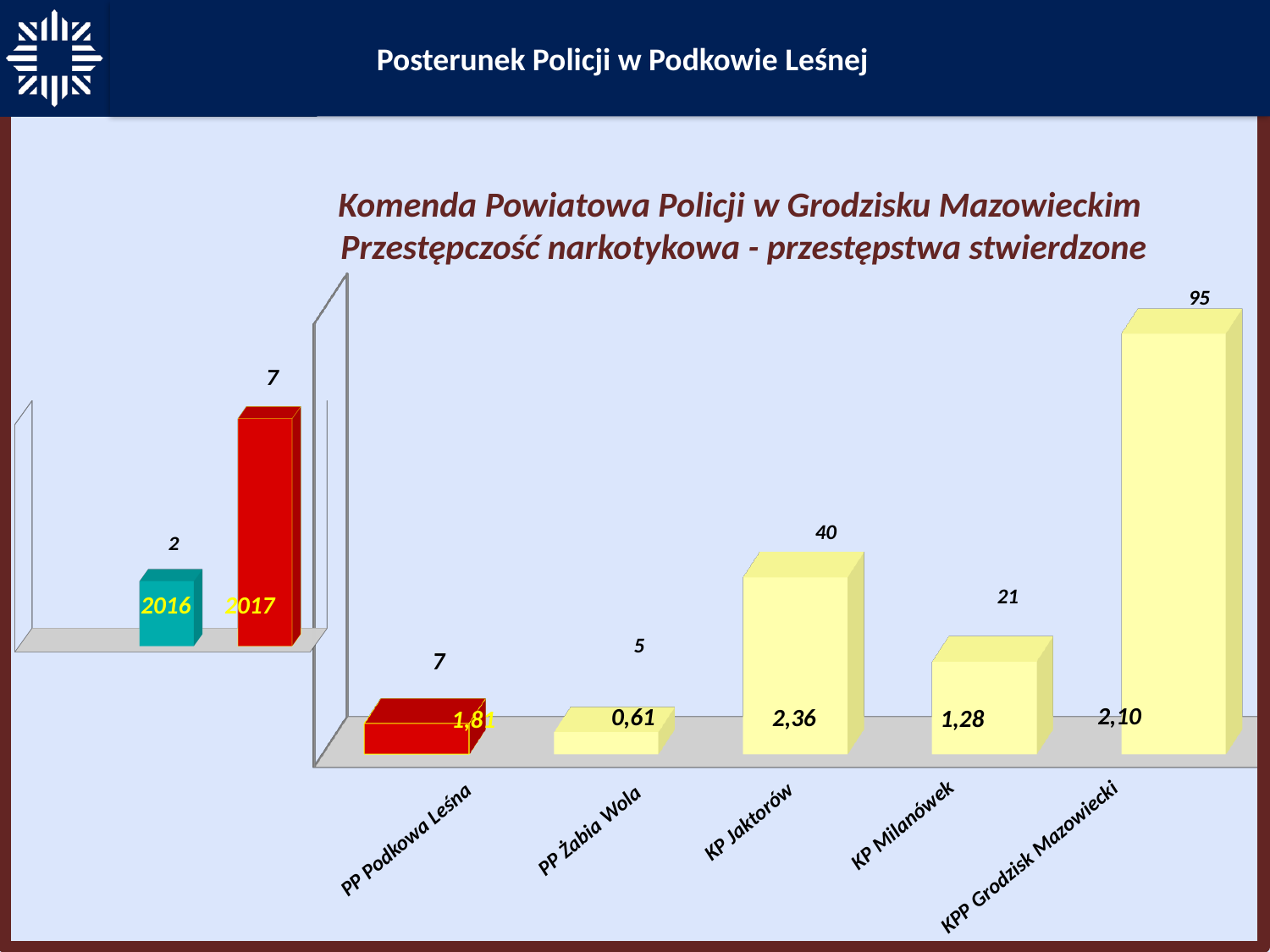
In the large chart titled 'Przestępczość narkotykowa - przestępstwa stwierdzone', what is the value for KPP Grodzisk Mazowiecki? 95 In the large chart titled 'Przestępczość narkotykowa - przestępstwa stwierdzone', which category has the lowest value? PP Żabia Wola In the large chart titled 'Przestępczość narkotykowa - przestępstwa stwierdzone', what is the value for KP Milanówek? 21 How many categories are shown in the large chart titled 'Przestępczość narkotykowa - przestępstwa stwierdzone'? 5 In the small chart on the left of the slide, what is the value for 2017? 7 In the large chart titled 'Przestępczość narkotykowa - przestępstwa stwierdzone', which is larger: the value for KP Milanówek or the value for PP Podkowa Leśna? KP Milanówek In the small chart on the left of the slide, what is the difference between the values for 2017 and 2016? 5 In the large chart titled 'Przestępczość narkotykowa - przestępstwa stwierdzone', what is the value for KP Jaktorów? 40 What kind of chart is the large chart titled 'Przestępczość narkotykowa - przestępstwa stwierdzone'? bar chart In the large chart titled 'Przestępczość narkotykowa - przestępstwa stwierdzone', what is the difference between the values for KPP Grodzisk Mazowiecki and KP Jaktorów? 55 In the large chart titled 'Przestępczość narkotykowa - przestępstwa stwierdzone', what is the value for PP Żabia Wola? 5 In the large chart titled 'Przestępczość narkotykowa - przestępstwa stwierdzone', which category has the highest value? KPP Grodzisk Mazowiecki